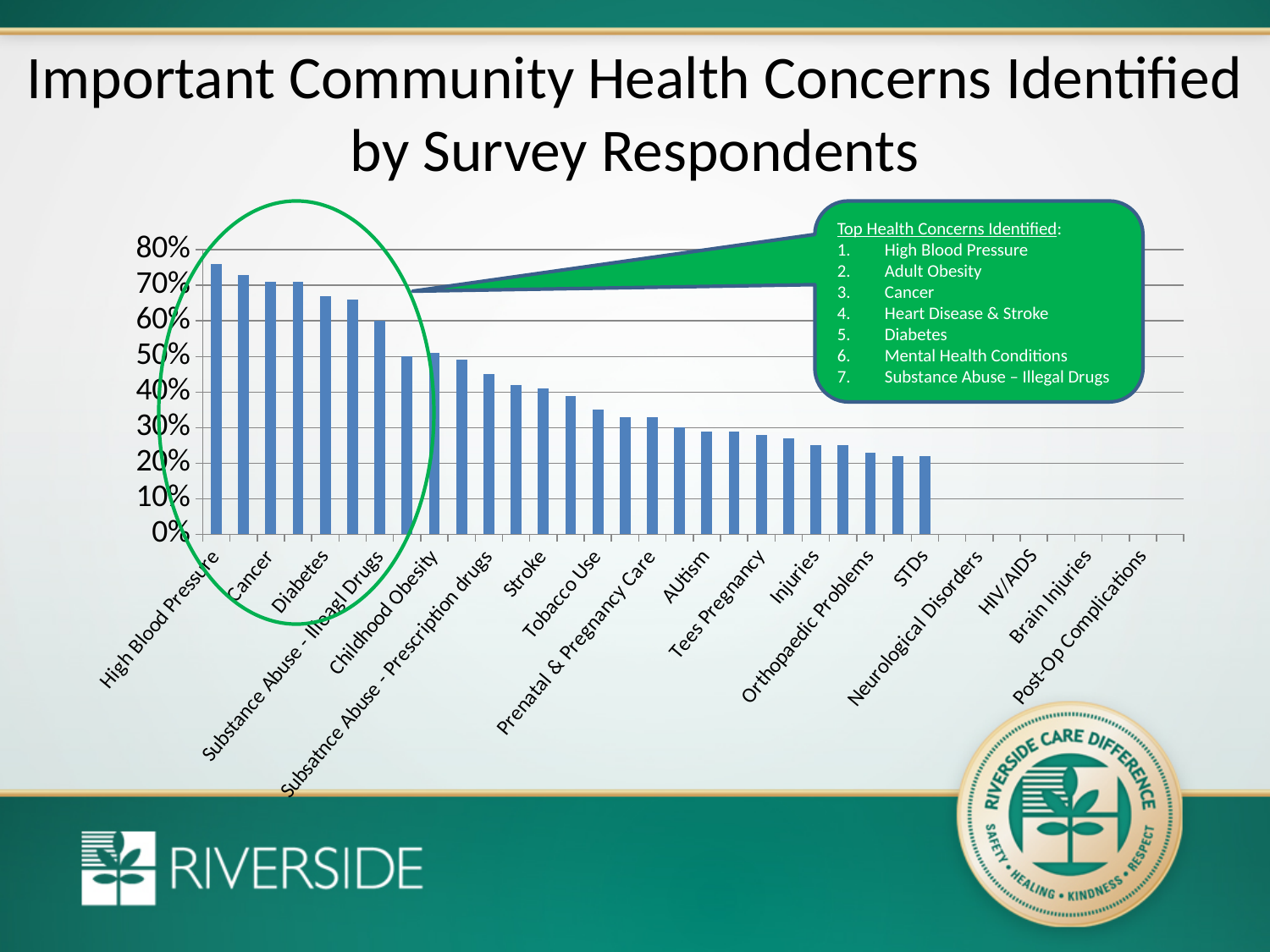
Which category has the highest value in the chart? High Blood Pressure Is the value for Cancer greater or less than 60%? greater What is the title of the chart on the slide? Important Community Health Concerns Identified by Survey Respondents What kind of chart is shown on the slide? bar chart Is the value for STDs greater or less than 30%? less Is the value for High Blood Pressure greater or less than 70%? greater How many top health concerns are listed in the green callout box? 7 Which has a larger value, High Blood Pressure or Stroke? High Blood Pressure Do the bar values rise or fall moving from left to right along the x axis? fall